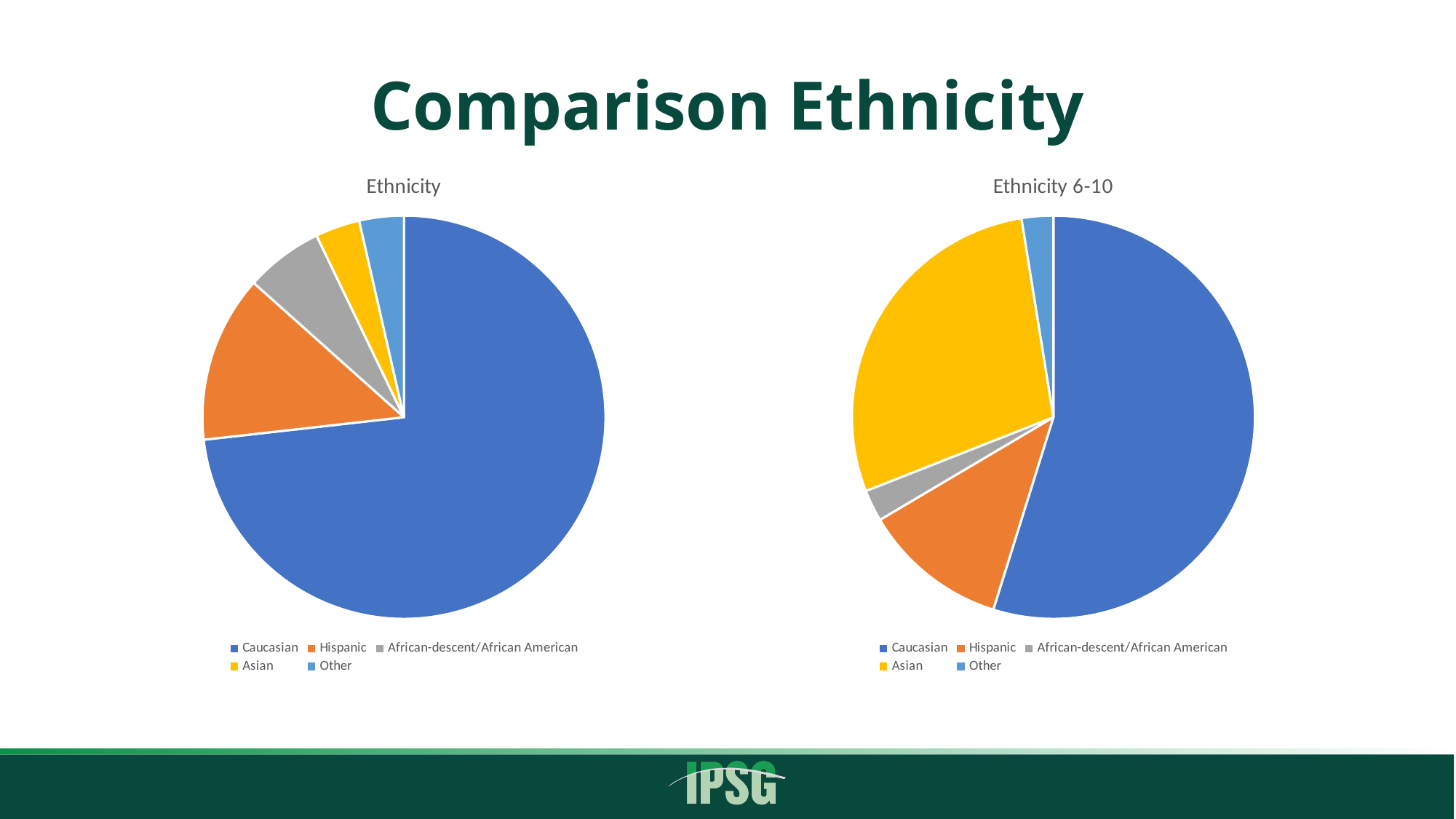
In the chart titled "Ethnicity", how many slices does the pie have? 5 In the chart titled "Ethnicity 6-10", which slice is larger, Hispanic or Other? Hispanic What kind of chart is the chart titled "Ethnicity 6-10"? pie chart What kind of chart is the chart titled "Ethnicity"? pie chart In the chart titled "Ethnicity 6-10", how many categories does the legend list? 5 In the chart titled "Ethnicity 6-10", what colour is the Asian slice? yellow In the chart titled "Ethnicity", which category has the largest slice? Caucasian In the chart titled "Ethnicity", which slice is larger, Hispanic or African-descent/African American? Hispanic In the chart titled "Ethnicity 6-10", which slice is larger, Asian or Hispanic? Asian What is the title of the pie chart on the right side of the slide? Ethnicity 6-10 In the chart titled "Ethnicity 6-10", which category has the largest slice? Caucasian